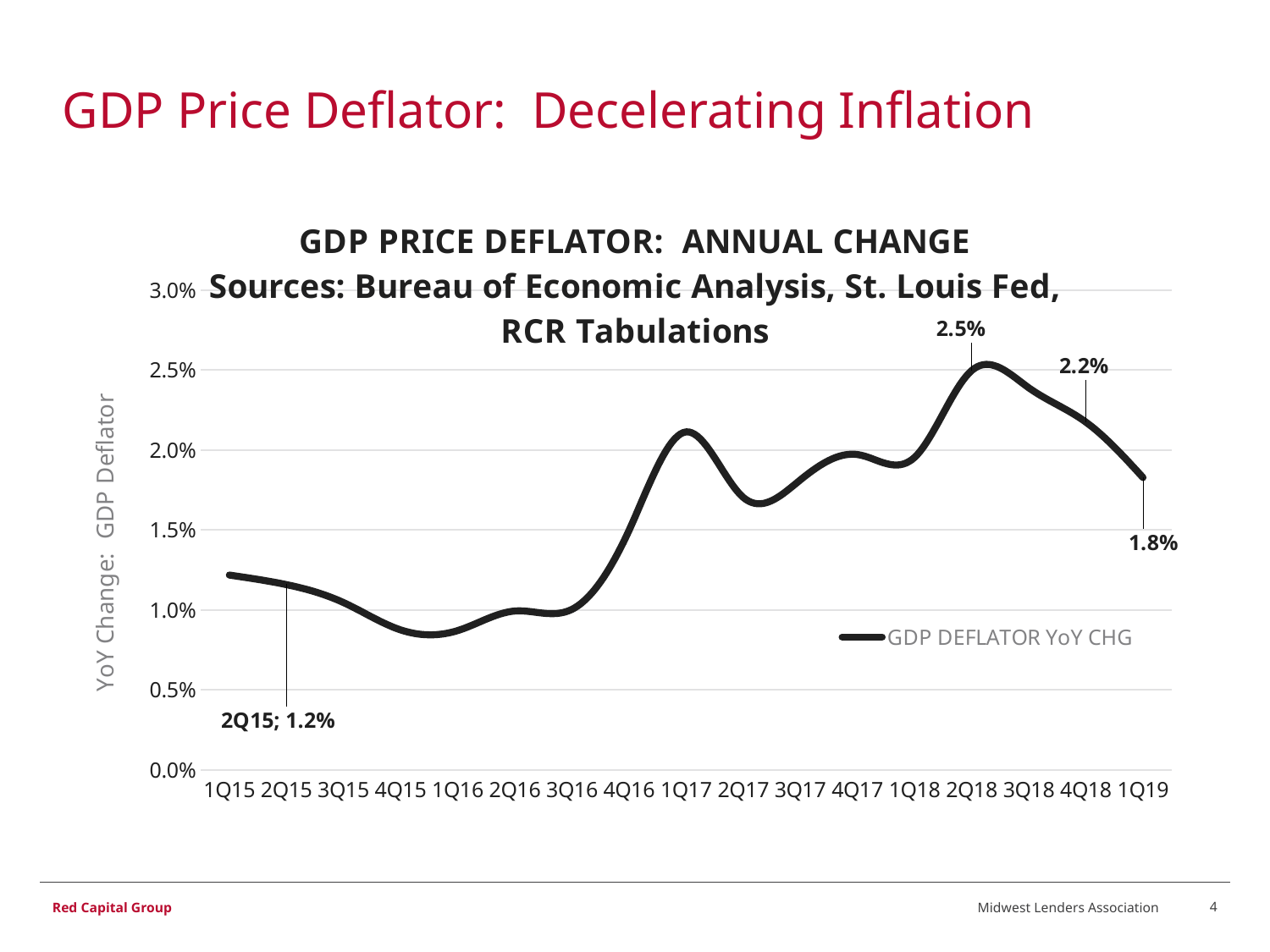
How many quarters are plotted on the x axis? 17 Which is larger, the value for 2Q18 or the value for 1Q19? 2Q18 Is the value for 1Q16 greater or less than 1.0%? less What is the value for 4Q18? 2.2% What is the difference between the values for 2Q18 and 1Q19? 0.7 percentage points What is the value for 1Q19? 1.8% Do the values rise or fall from 2Q18 to 1Q19? fall What kind of chart is shown? line chart What is the value for 2Q15? 1.2% Which quarter has the highest GDP deflator YoY change? 2Q18 What is the value for 2Q18? 2.5%